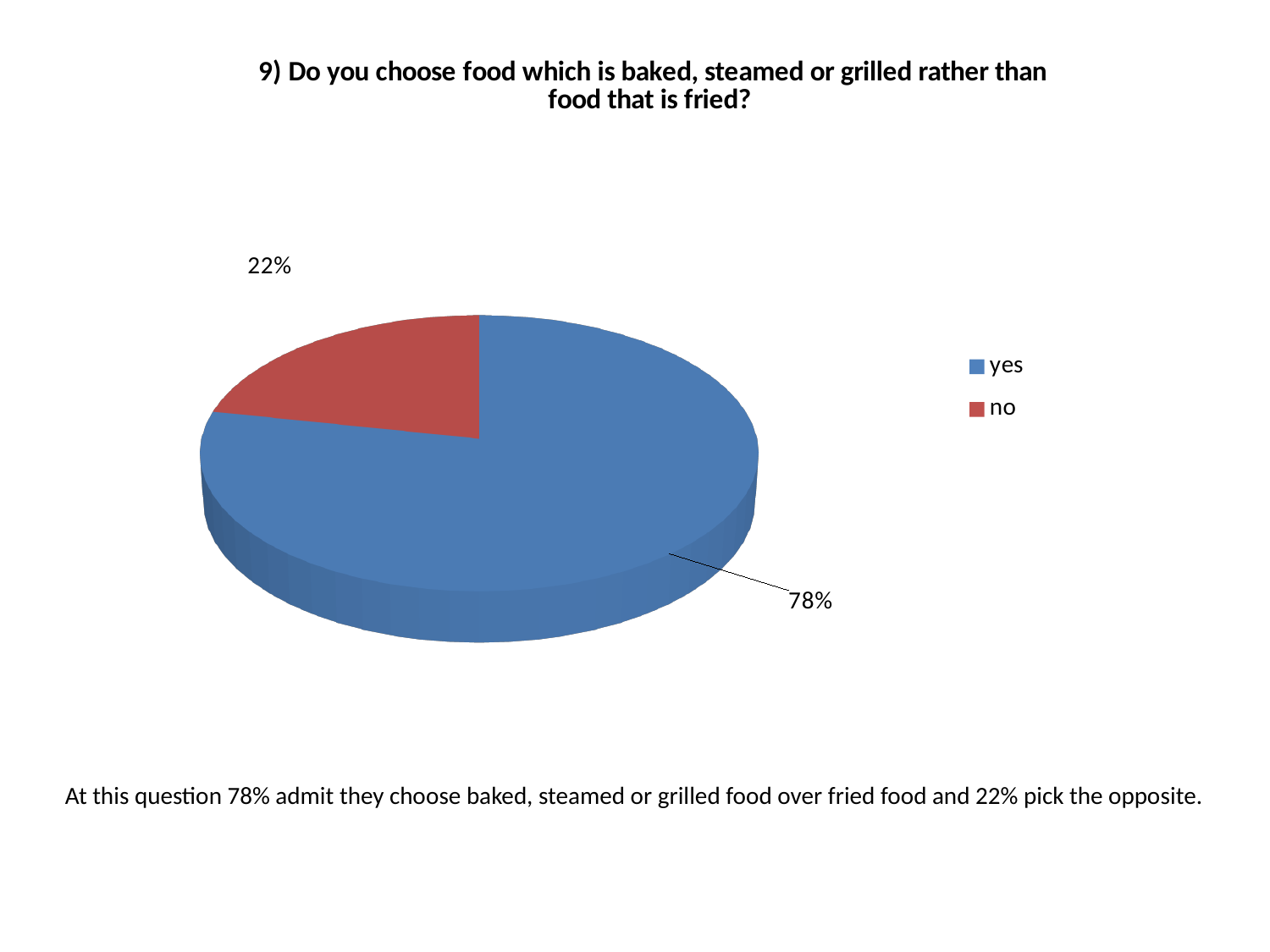
What colour is the "yes" slice? blue Which slice is larger, "yes" or "no"? yes What share of the pie does the "no" slice represent? 22% What percentage of respondents answered "yes"? 78% What is the difference in percentage points between the "yes" and "no" slices? 56 What kind of chart is shown on the slide? pie chart Which answer has the smallest share of the pie? no How many entries does the legend list? 2 What percentage of respondents answered "no"? 22% How many slices does the pie chart have? 2 What colour is the "no" slice? red Which answer has the largest share of the pie? yes